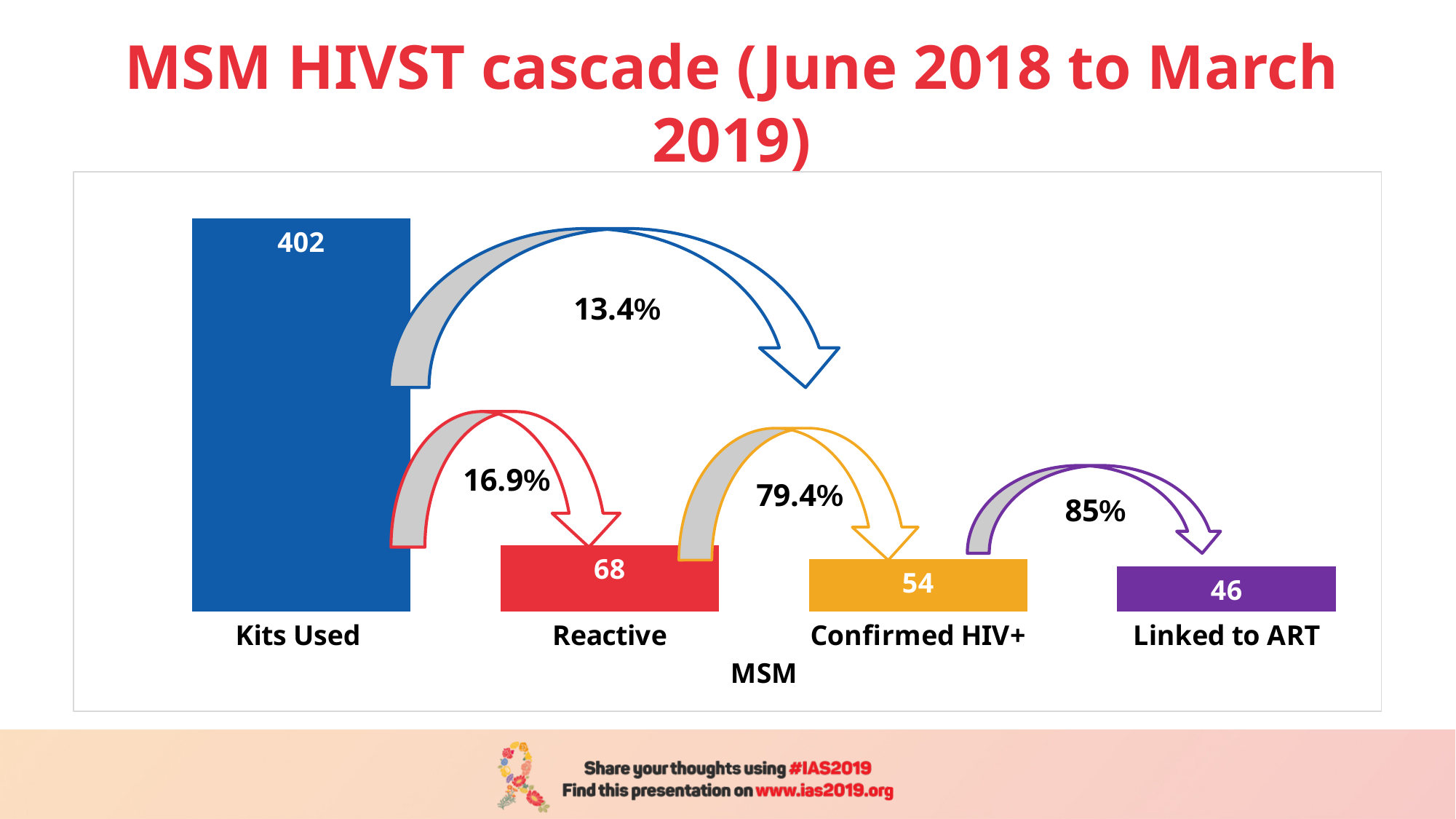
What is the value for Confirmed HIV+? 54 What percentage is shown on the arrow from Confirmed HIV+ to Linked to ART? 85% Which is larger, Confirmed HIV+ or Linked to ART? Confirmed HIV+ What is the value for Kits Used? 402 How many categories are shown on the x axis? 4 What is the difference between the Reactive and Confirmed HIV+ values? 14 What is the value for Linked to ART? 46 Which category has the lowest value? Linked to ART What is the value for Reactive? 68 What kind of chart is this? Bar chart Which category has the highest value? Kits Used What is the difference between the Kits Used and Reactive values? 334